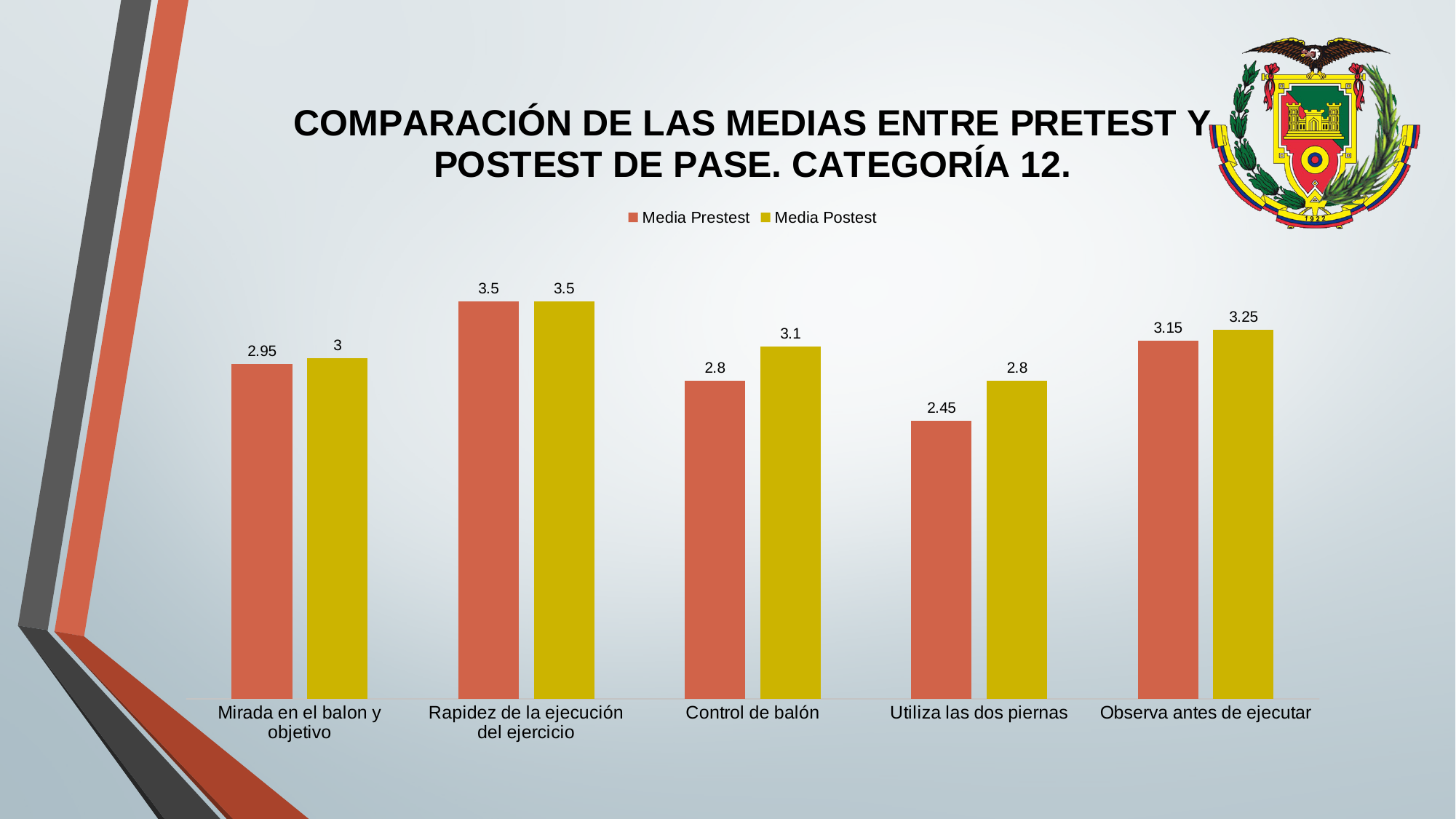
How many series does the legend list? 2 Which colour represents the Media Postest series? Yellow How many categories are shown on the x axis? 5 What is the Media Postest value for Observa antes de ejecutar? 3.25 What is the Media Prestest value for Control de balón? 2.8 Which category has the lowest Media Prestest value? Utiliza las dos piernas What kind of chart is shown on the slide? Bar chart Which category has the highest Media Postest value? Rapidez de la ejecución del ejercicio What is the difference between the Media Postest and Media Prestest values for Control de balón? 0.3 What is the difference between the Media Postest and Media Prestest values for Utiliza las dos piernas? 0.35 What is the Media Postest value for Mirada en el balon y objetivo? 3 Which is larger for Observa antes de ejecutar: Media Prestest or Media Postest? Media Postest